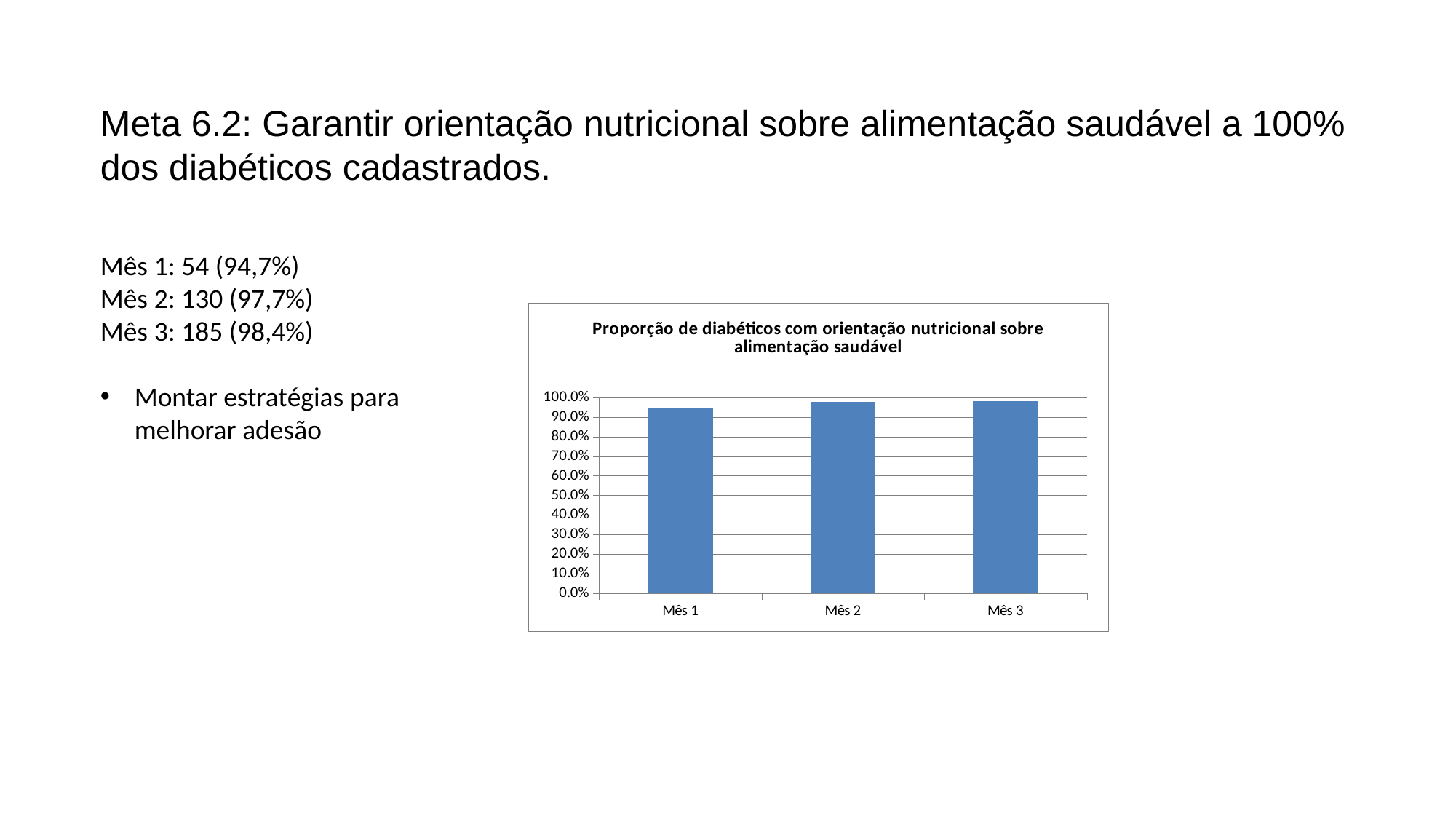
Is the value for Mês 1 greater or less than 100.0%? less What kind of chart is shown on the slide? bar chart Is the value for Mês 1 greater or less than 90.0%? greater Which is larger in the chart, the value for Mês 1 or the value for Mês 3? Mês 3 How many categories are plotted on the x axis of the chart? 3 What is the highest tick value shown on the y axis of the chart? 100.0% What is the title of the chart? Proporção de diabéticos com orientação nutricional sobre alimentação saudável Do the values rise or fall from Mês 1 to Mês 3 in the chart? rise Is the value for Mês 3 greater or less than 90.0%? greater Which is larger in the chart, the value for Mês 1 or the value for Mês 2? Mês 2 Which category has the lowest bar in the chart? Mês 1